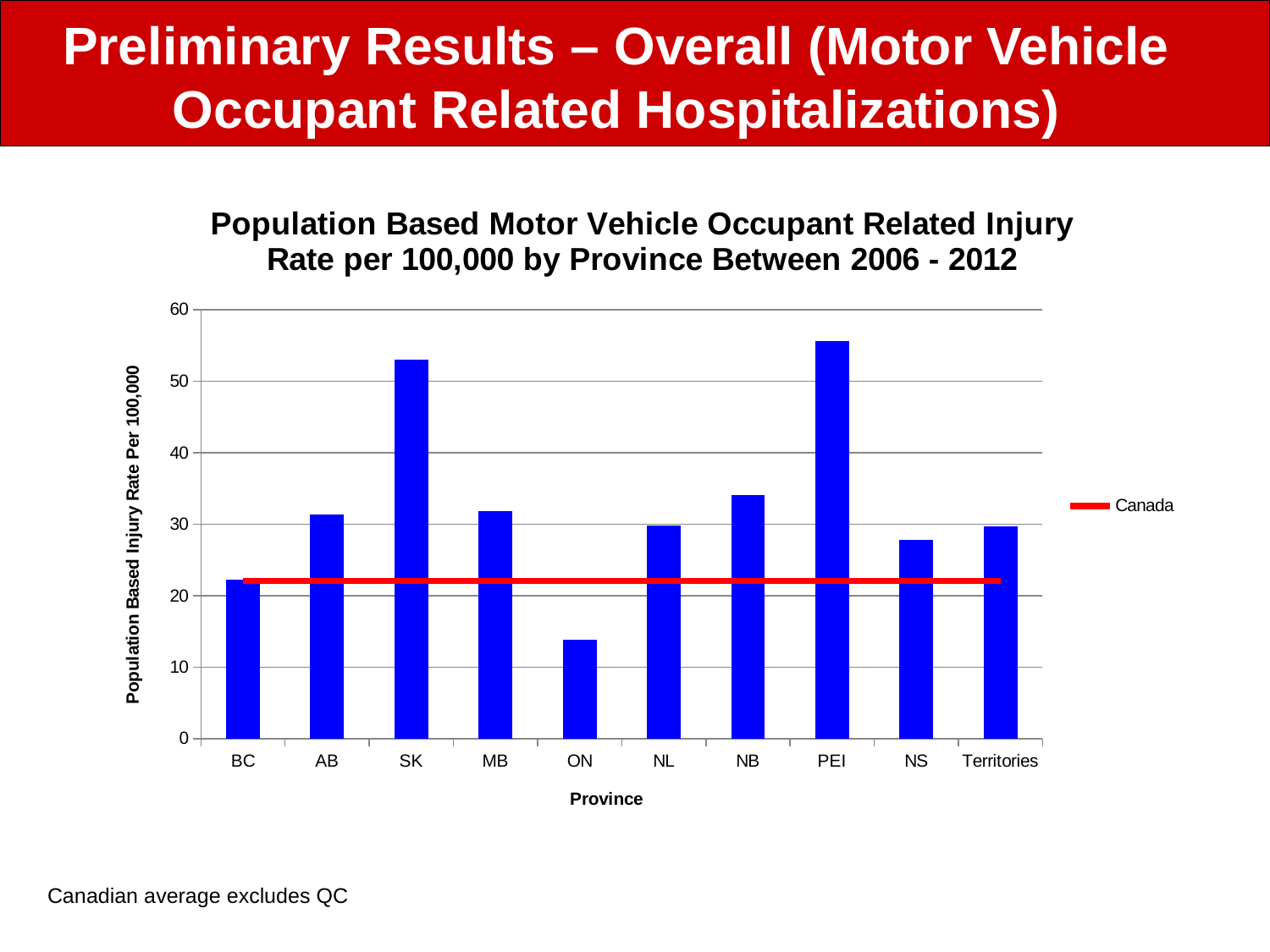
What colour is the horizontal line representing Canada in the chart? red Which province has the highest population based injury rate in the chart? PEI Is the value for SK greater or less than 50? greater Is the value for ON greater or less than 20? less Is the value for NS greater or less than 30? less Which has the larger injury rate, BC or ON? BC What kind of chart is shown on the slide? bar chart How many provinces/regions are shown on the x axis of the chart? 10 Which has the larger injury rate, SK or MB? SK Which province has the lowest population based injury rate in the chart? ON What entry does the chart legend list? Canada